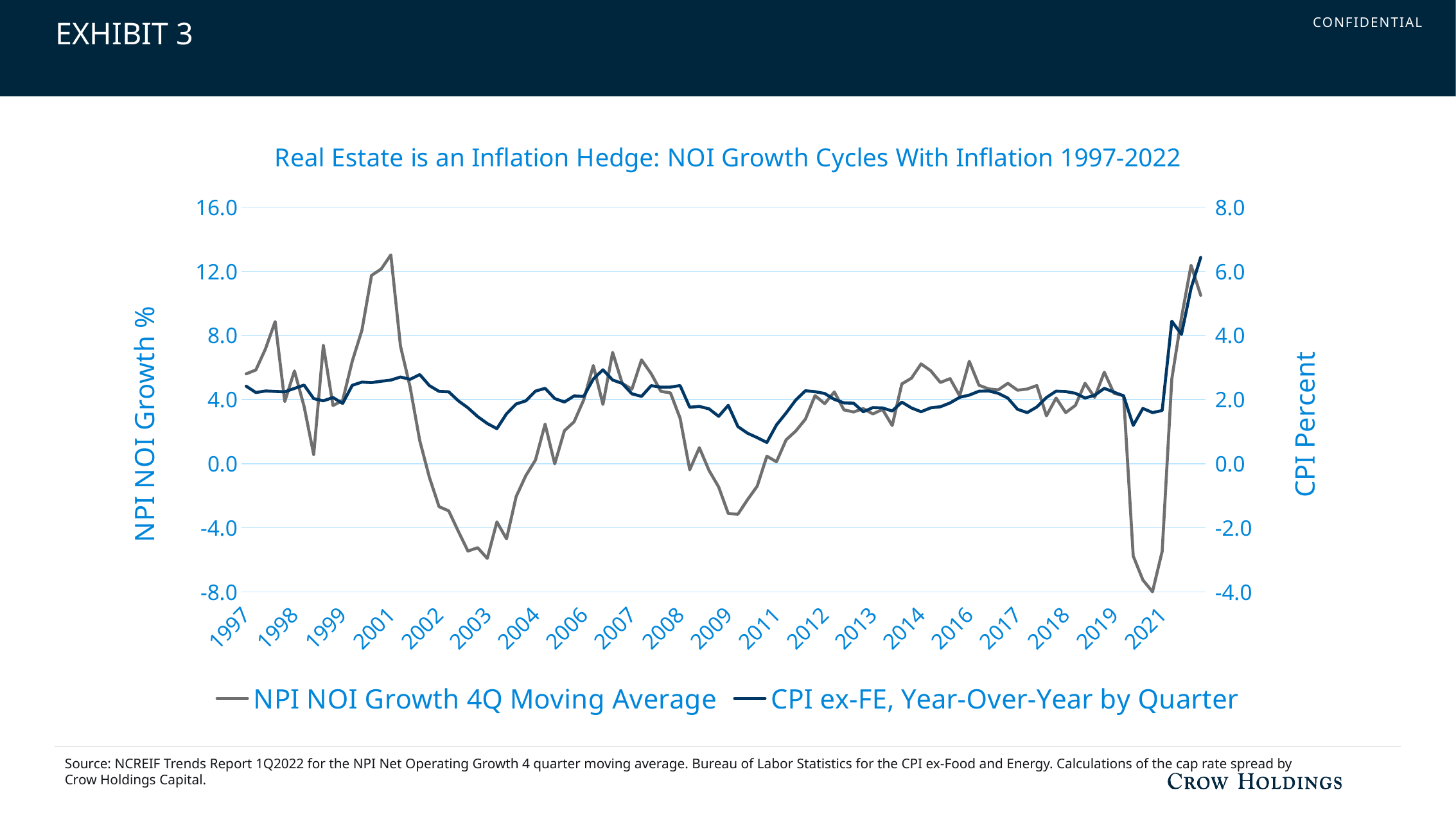
Does the NPI NOI Growth 4Q Moving Average line rise or fall between 2001 and 2003? fall Does the CPI ex-FE, Year-Over-Year by Quarter line rise or fall between 2021 and the right end of the chart? rise How many year labels appear on the x axis? 20 What is the label on the right-hand vertical axis? CPI Percent Is the trough of the NPI NOI Growth 4Q Moving Average line deeper near 2003 or near 2021? near 2021 What kind of chart is shown on the slide? Line chart Is the peak of the NPI NOI Growth 4Q Moving Average line around 2001 greater or less than 8.0? greater Is the CPI ex-FE, Year-Over-Year by Quarter line around 2011 greater or less than 2.0 on the right axis? less What is the title of the chart? Real Estate is an Inflation Hedge: NOI Growth Cycles With Inflation 1997-2022 Is the lowest value of the NPI NOI Growth 4Q Moving Average line greater or less than -4.0? less How many series does the legend list? 2